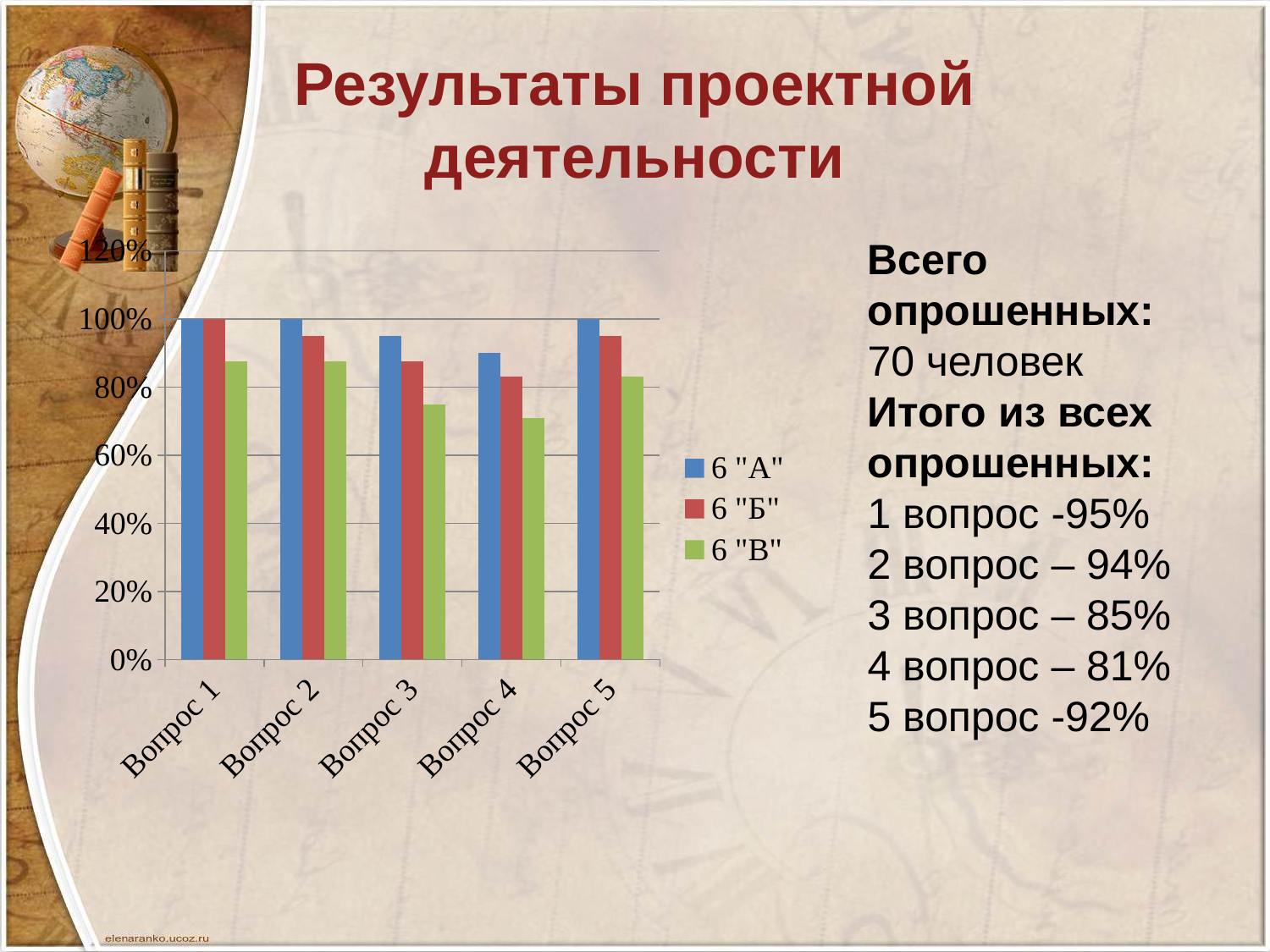
How many series does the chart legend list? 3 Is the value for 6 "В" at Вопрос 3 greater or less than 80%? less At Вопрос 3, which series has the larger value: 6 "А" or 6 "В"? 6 "А" How many categories (questions) are shown on the x axis of the chart? 5 Is the value for 6 "А" at Вопрос 4 greater or less than 80%? greater What colour are the bars for the series 6 "А"? Blue What is the value for 6 "А" at Вопрос 1? 100% Is the value for 6 "В" at Вопрос 4 greater or less than 80%? less What kind of chart is shown on the slide? Bar chart What is the value for 6 "Б" at Вопрос 1? 100% Do the values for 6 "В" rise or fall from Вопрос 1 to Вопрос 4? Fall What are the series names listed in the chart legend? 6 "А", 6 "Б", 6 "В"